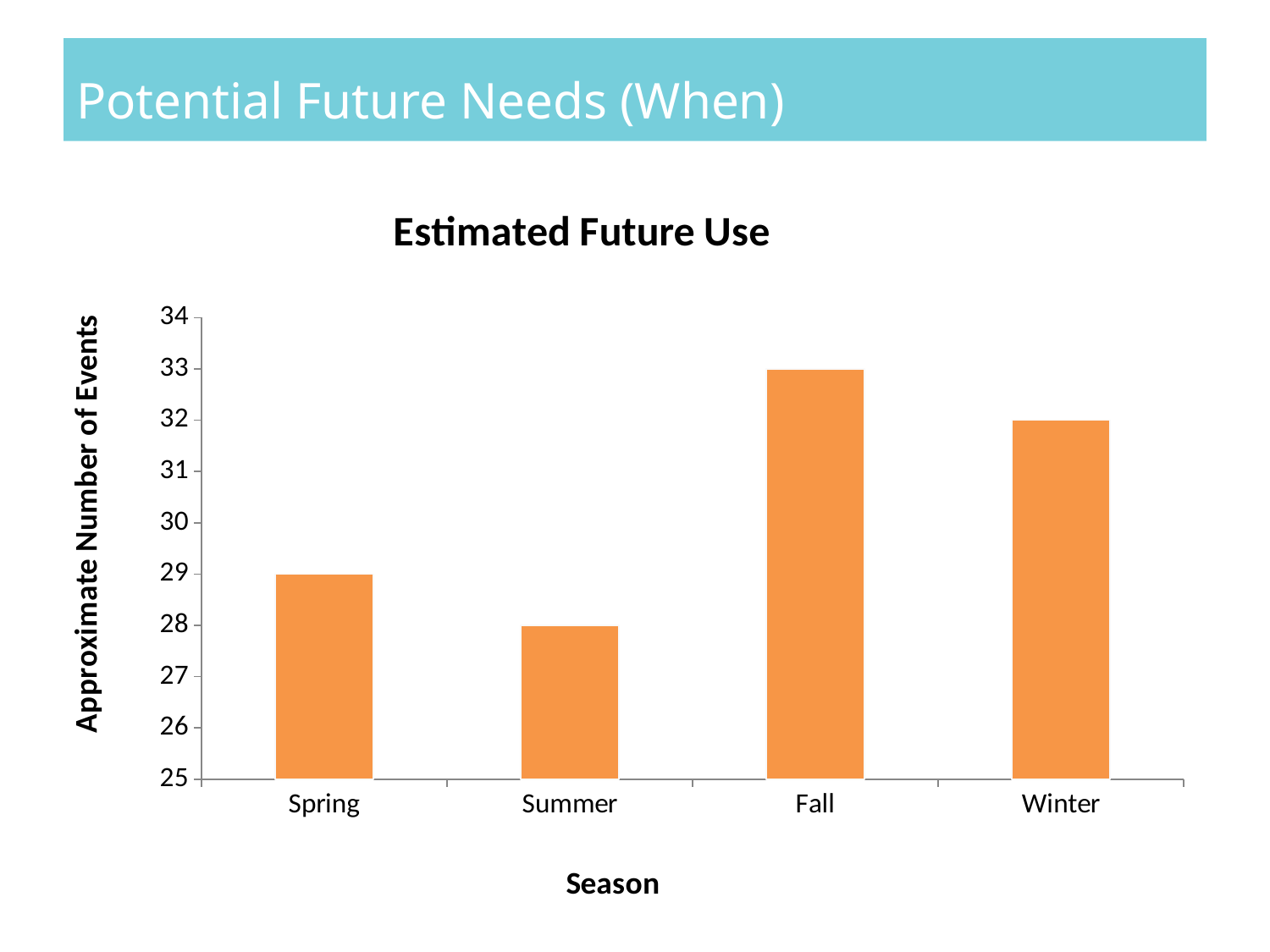
What kind of chart is shown on the slide? Bar chart What is the title of the chart? Estimated Future Use What is the difference in the number of events between Fall and Summer? 5 What is the approximate number of events for Spring? 29 What is the difference in the number of events between Winter and Spring? 3 What is the approximate number of events for Fall? 33 Which season has the highest estimated future use? Fall Which has a higher number of events, Spring or Summer? Spring What is the approximate number of events for Winter? 32 How many seasons are shown on the x axis? 4 Is the value for Winter greater or less than 30? greater Which season has the lowest estimated future use? Summer